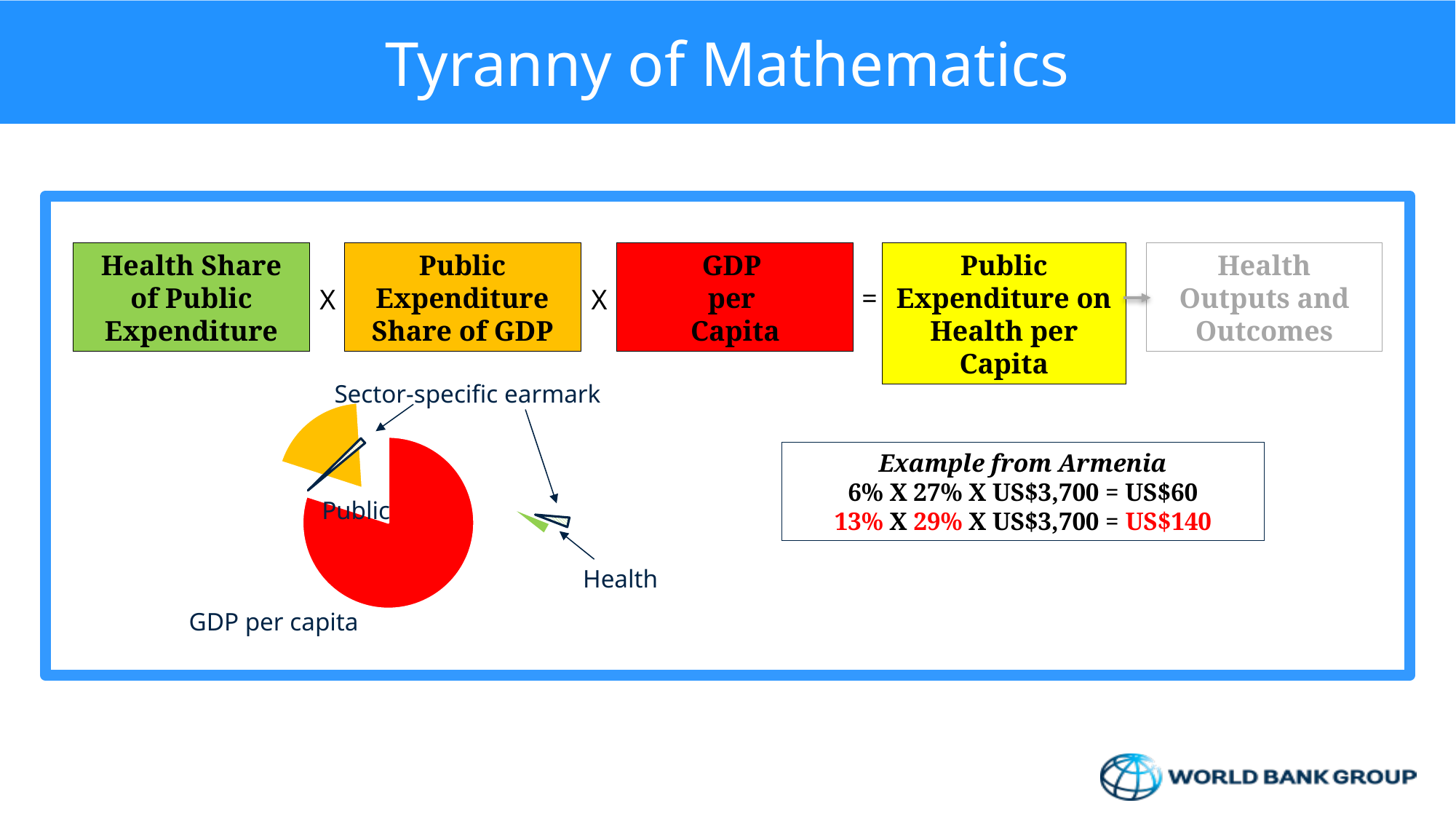
What colour is the GDP per capita slice of the pie chart? Red What colour is the Health slice of the pie chart? Green In the pie chart, which is larger: the GDP per capita slice or the Public slice? GDP per capita In the pie chart, which is larger: the Public slice or the Health slice? Public What kind of chart is shown on the slide? Pie chart Which slice of the pie chart is the largest? GDP per capita